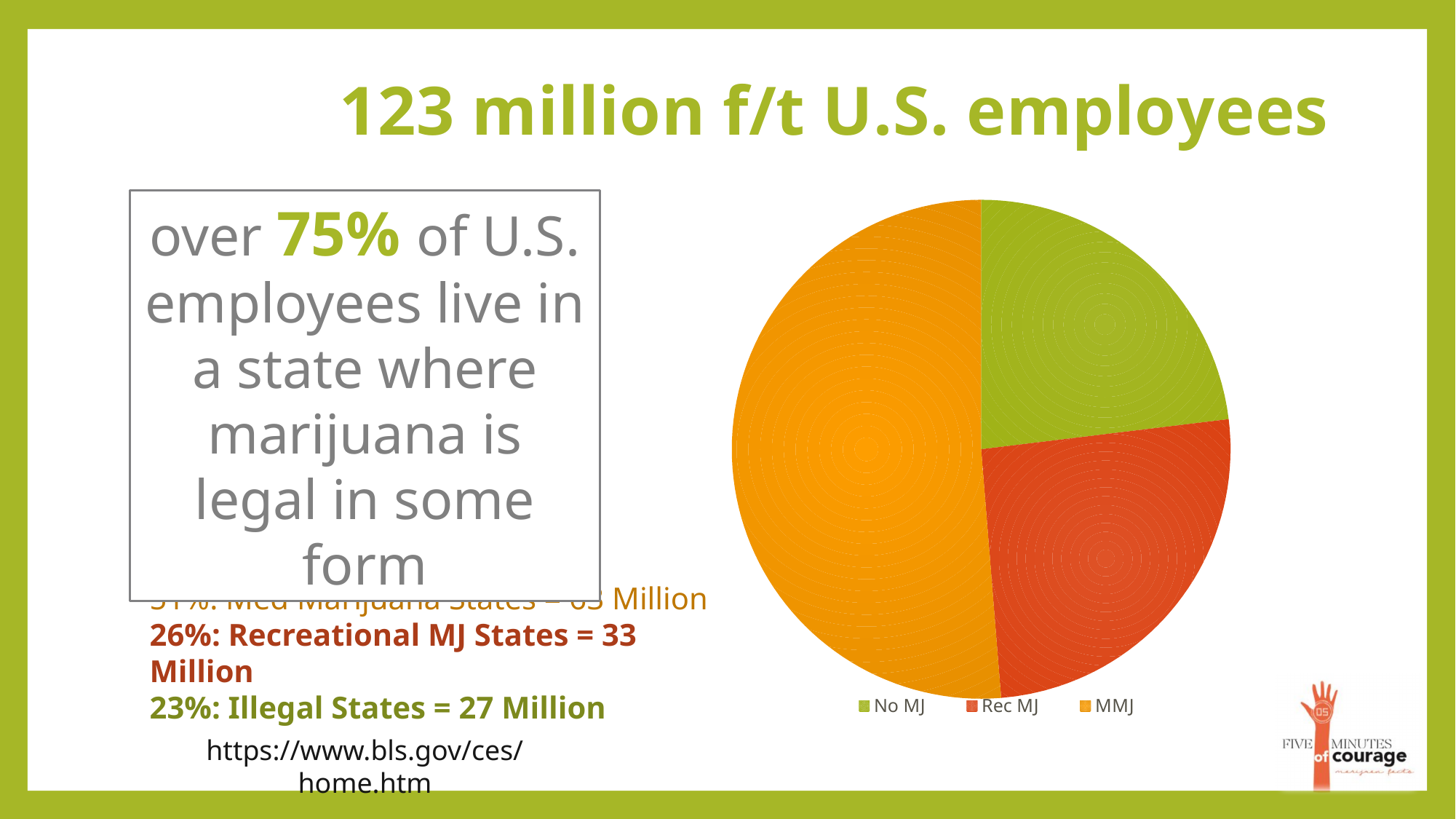
What colour is the No MJ slice in the pie chart? green Which is larger in the pie chart, the MMJ slice or the Rec MJ slice? MMJ How many entries does the pie chart's legend list? 3 Which is larger in the pie chart, the MMJ slice or the No MJ slice? MMJ What is the title of the slide containing the pie chart? 123 million f/t U.S. employees According to the slide text, what percentage of employees live in Recreational MJ States? 26% How many slices does the pie chart have? 3 According to the slide text, how many more employees live in Recreational MJ States than in Illegal States? 6 Million According to the slide text, how many employees live in Illegal States? 27 Million What kind of chart is shown on the slide? pie chart Which slice of the pie chart is the largest? MMJ